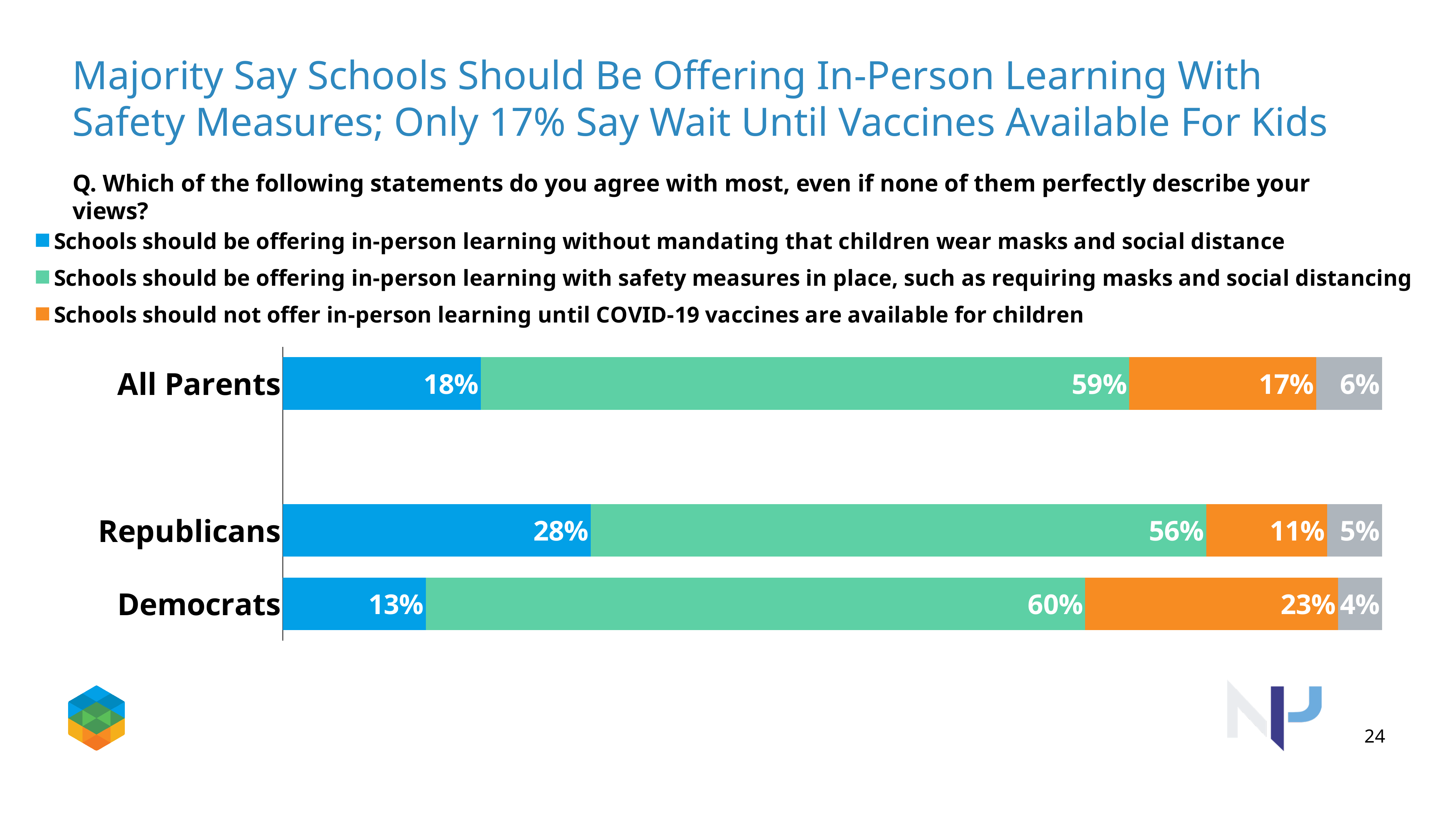
What colour represents the statement that schools should not offer in-person learning until COVID-19 vaccines are available for children? Orange What is the difference between Republicans and Democrats in the percentage saying schools should offer in-person learning without mandating masks and social distancing? 15% What percentage of Democrats say schools should not offer in-person learning until COVID-19 vaccines are available for children? 23% What percentage of All Parents say schools should be offering in-person learning with safety measures in place? 59% What percentage of Republicans say schools should be offering in-person learning without mandating masks and social distancing? 28% Which is larger: the percentage of Republicans or Democrats saying schools should not offer in-person learning until vaccines are available for children? Democrats Which group has the highest percentage saying schools should not offer in-person learning until vaccines are available for children? Democrats What type of chart is shown on the slide? Stacked bar chart How many groups (bars) are shown in the chart? 3 How many statements does the legend list? 3 Which group has the lowest percentage saying schools should be offering in-person learning without mandating masks and social distancing? Democrats What is the value of the grey segment for Republicans? 5%